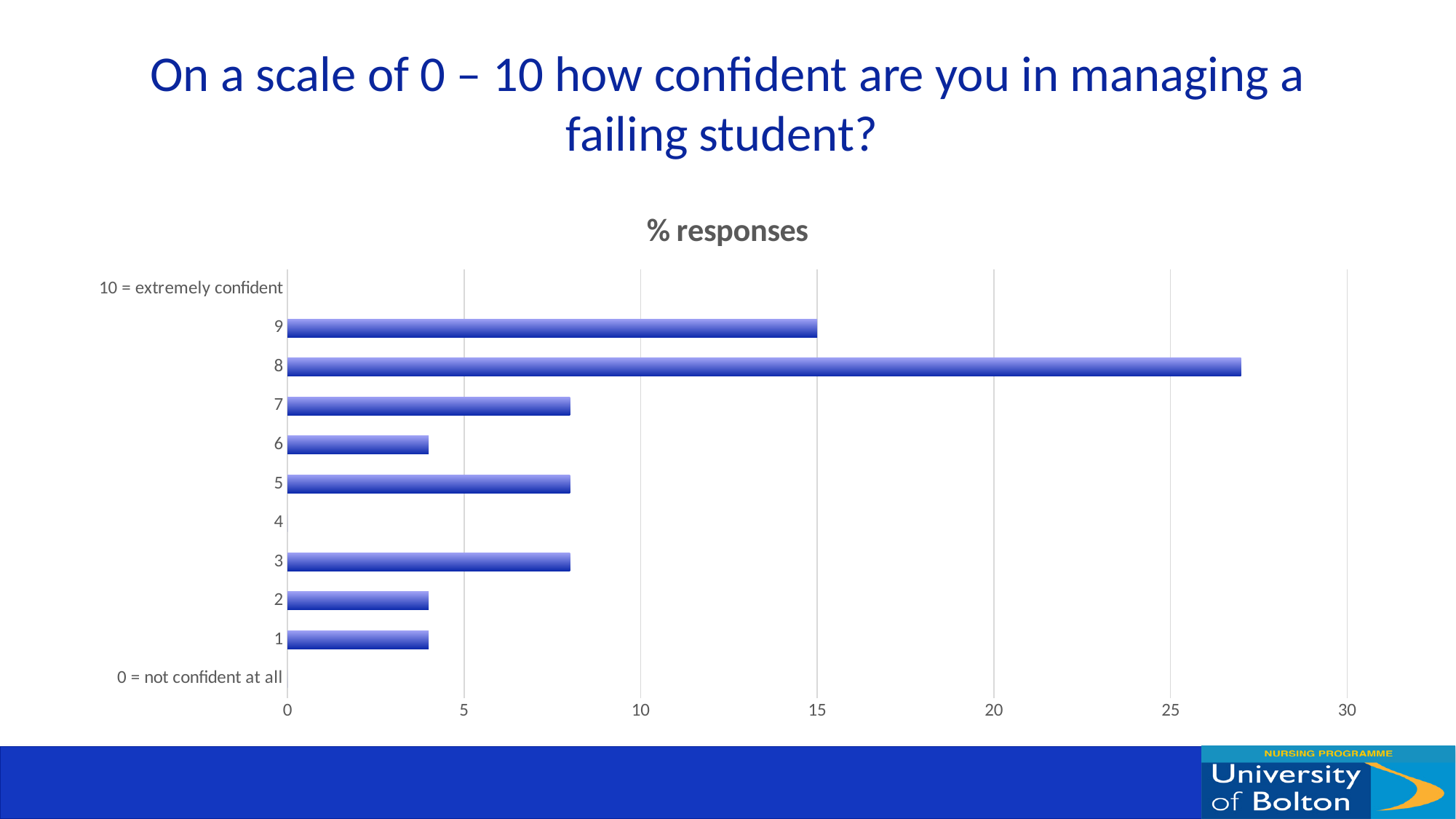
What is the value for rating 9? 15 Which is larger, the value for rating 3 or the value for rating 2? 3 Is the value for rating 9 greater or less than 20? less Is the value for rating 6 greater or less than 5? less What kind of chart is shown on the slide? bar chart Which is larger, the value for rating 8 or the value for rating 9? 8 How many confidence rating categories are shown on the vertical axis? 11 Is the value for rating 8 greater or less than 25? greater Which confidence rating has the highest percentage of responses? 8 What is the title of the chart? % responses Which rating categories show no bar at all? 10 = extremely confident, 4, 0 = not confident at all